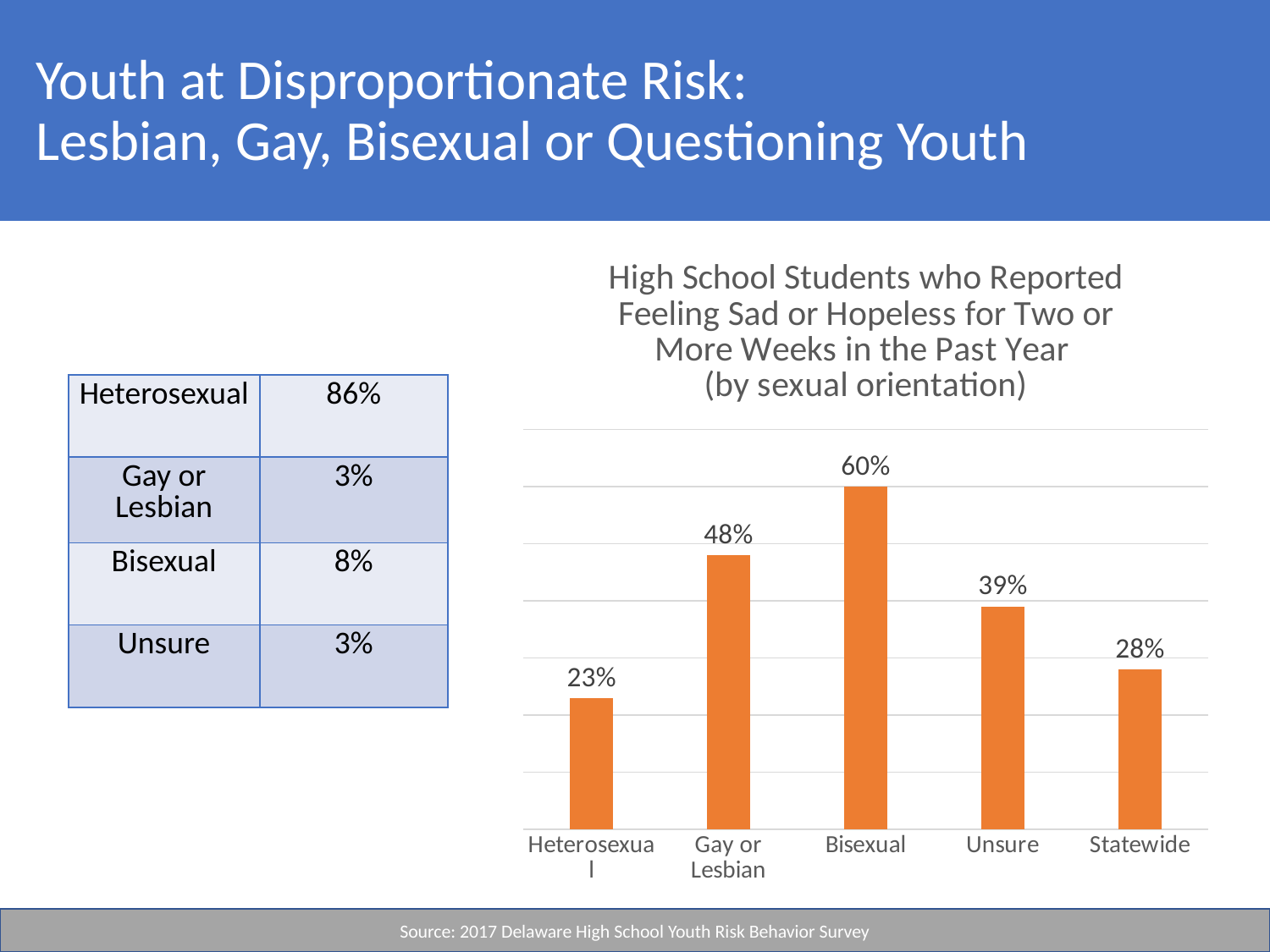
Which category has the lowest value in the chart? Heterosexual What is the value shown for Heterosexual students in the chart? 23% Which is larger in the chart, the value for Unsure or the value for Statewide? Unsure Which category has the highest value in the chart? Bisexual How many categories are shown on the x axis of the chart? 5 What is the difference between the Bisexual and Heterosexual values in the chart? 37% What kind of chart is shown on the slide? Bar chart What is the value for Unsure students in the chart? 39% What is the Statewide value shown in the chart? 28% What is the difference between the Gay or Lesbian value and the Statewide value? 20% What colour are the bars in the chart? Orange What percentage of Bisexual high school students reported feeling sad or hopeless for two or more weeks in the past year? 60%